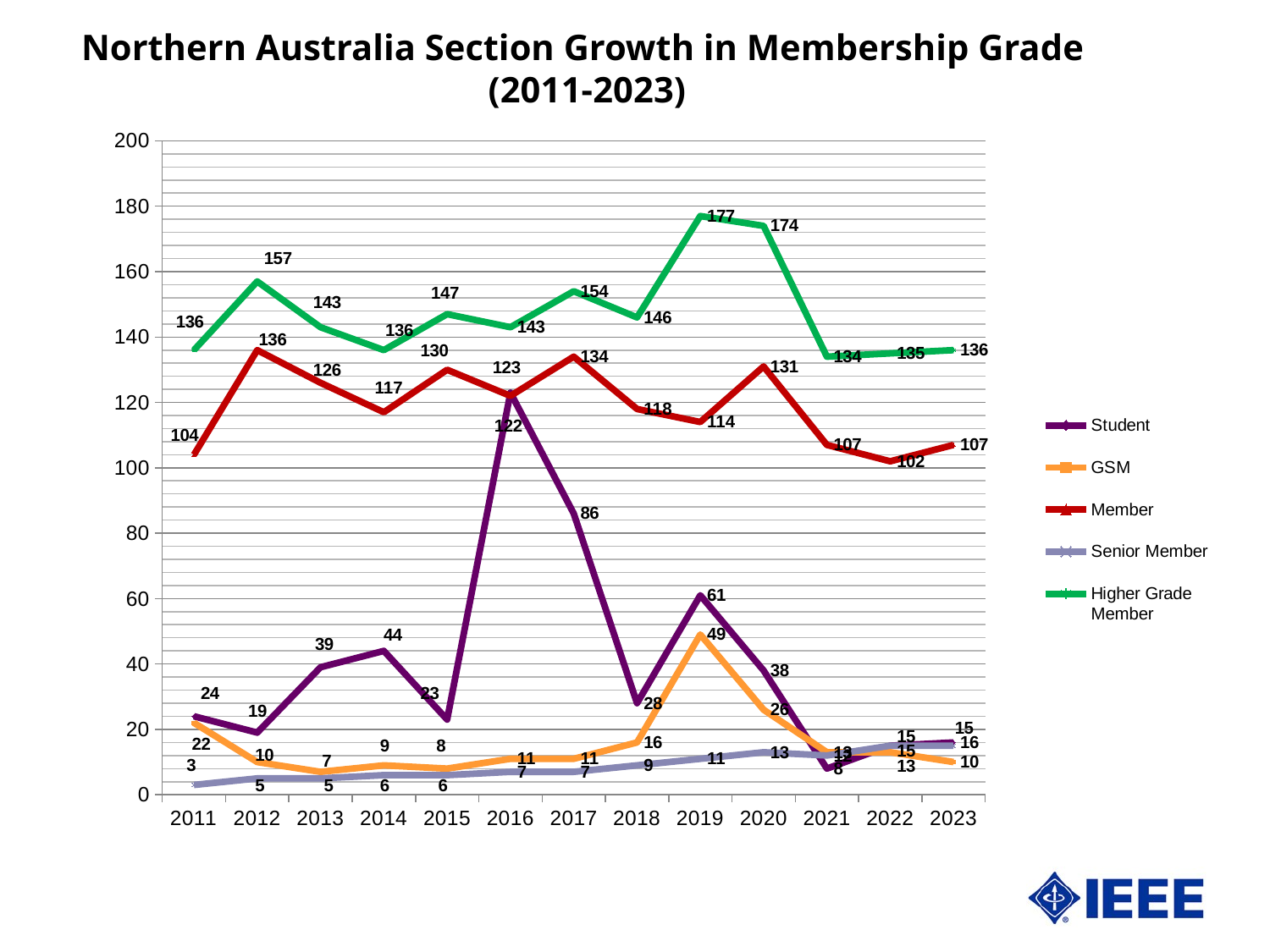
What is the difference between the Higher Grade Member values in 2019 and 2020? 3 In 2019, which is larger: the Student value or the GSM value? Student How many series does the legend list? 5 Does the Senior Member series rise or fall from 2011 to 2020? rise In which year does the Higher Grade Member series reach its highest value? 2019 In which year is the Member series at its lowest? 2022 By how much did the Member value increase from 2011 to 2012? 32 How many years are plotted along the x axis? 13 What is the Higher Grade Member value in 2019? 177 What is the Student value in 2016? 123 What is the GSM value in 2019? 49 What kind of chart is shown on the slide? line chart